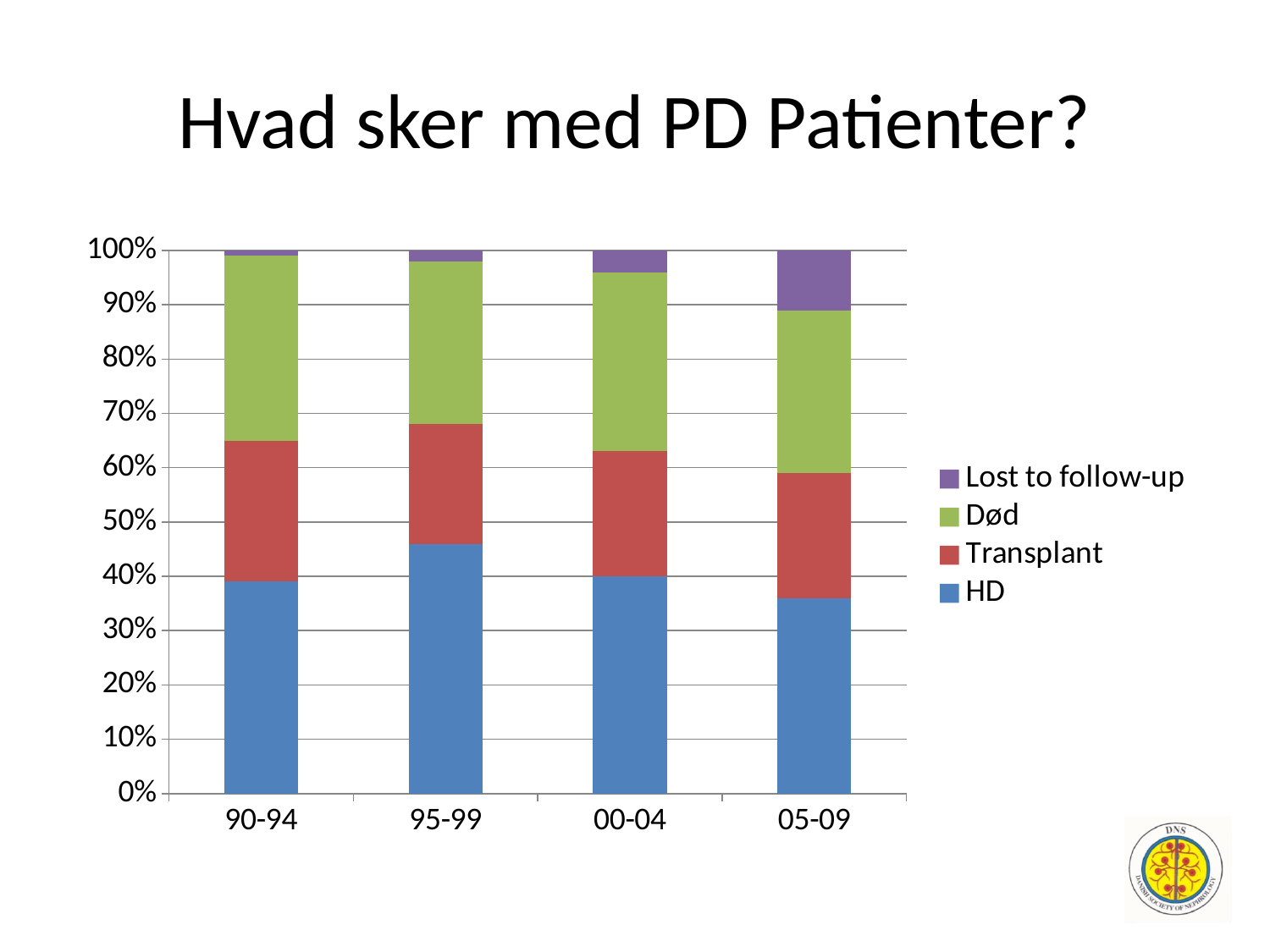
Which period has a larger HD share, 95-99 or 00-04? 95-99 Is the HD share for 05-09 greater or less than 40%? less Which series is shown in blue at the bottom of each bar? HD Is the HD share for 95-99 greater or less than 40%? greater What does each stacked bar total? 100% What kind of chart is shown on the slide? Stacked bar chart What is the title of the chart? Hvad sker med PD Patienter? In which period is the HD share the highest? 95-99 In which period is the Lost to follow-up share the largest? 05-09 How many time-period categories are shown on the x axis? 4 How many series does the legend list? 4